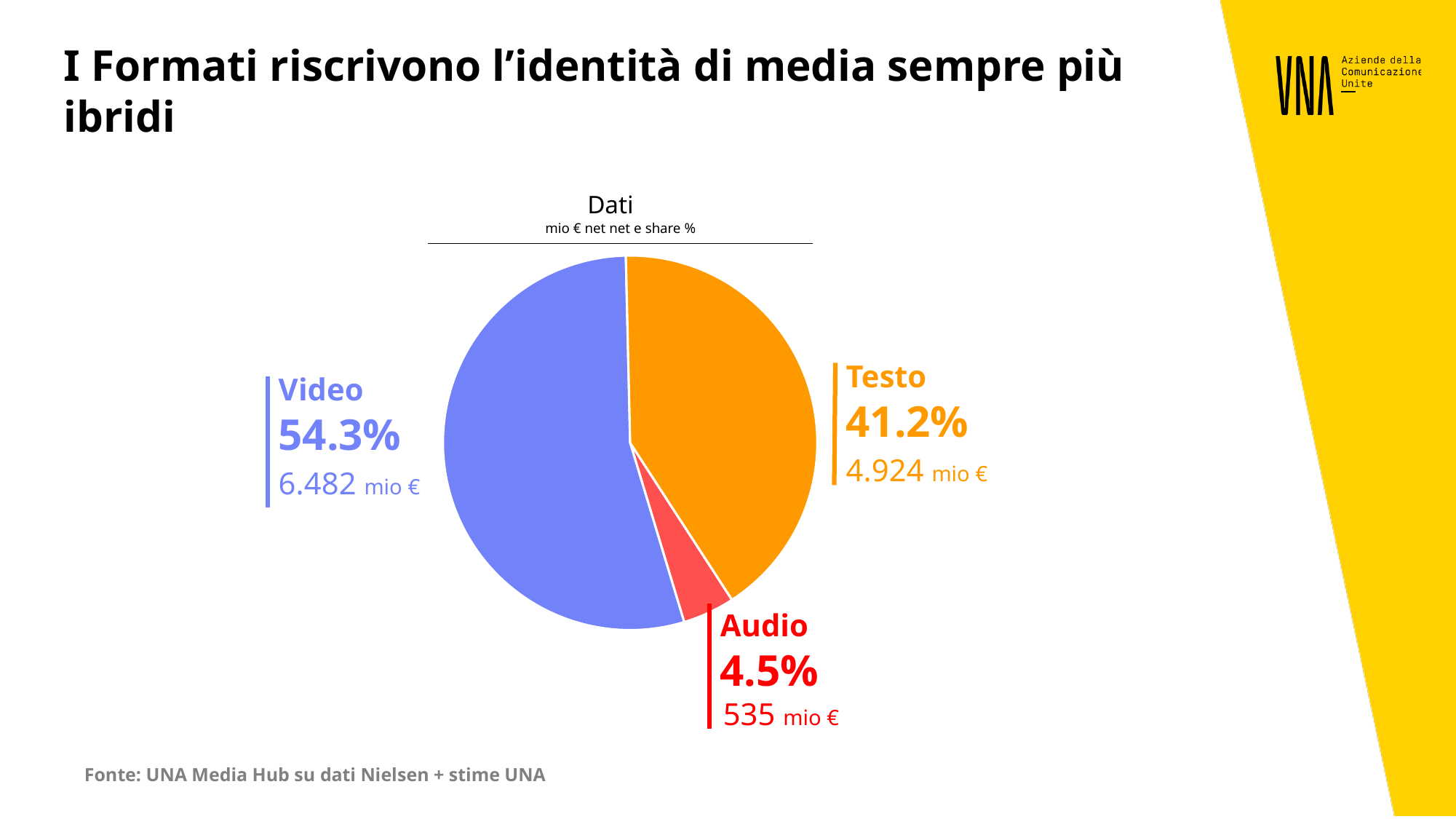
What is the value in mio € for Audio? 535 mio € Which category has the largest slice of the pie? Video Which category has the smallest slice of the pie? Audio What share of the pie does Testo account for? 41.2% What is the difference in percentage points between the Video share and the Testo share? 13.1 What is the value in mio € for Video? 6.482 mio € Which is larger, the value for Testo or the value for Audio? Testo How many slices does the pie chart have? 3 What is the value in mio € for Testo? 4.924 mio € What share of the pie does Video account for? 54.3% What type of chart is shown on the slide? pie chart What share of the pie does Audio account for? 4.5%